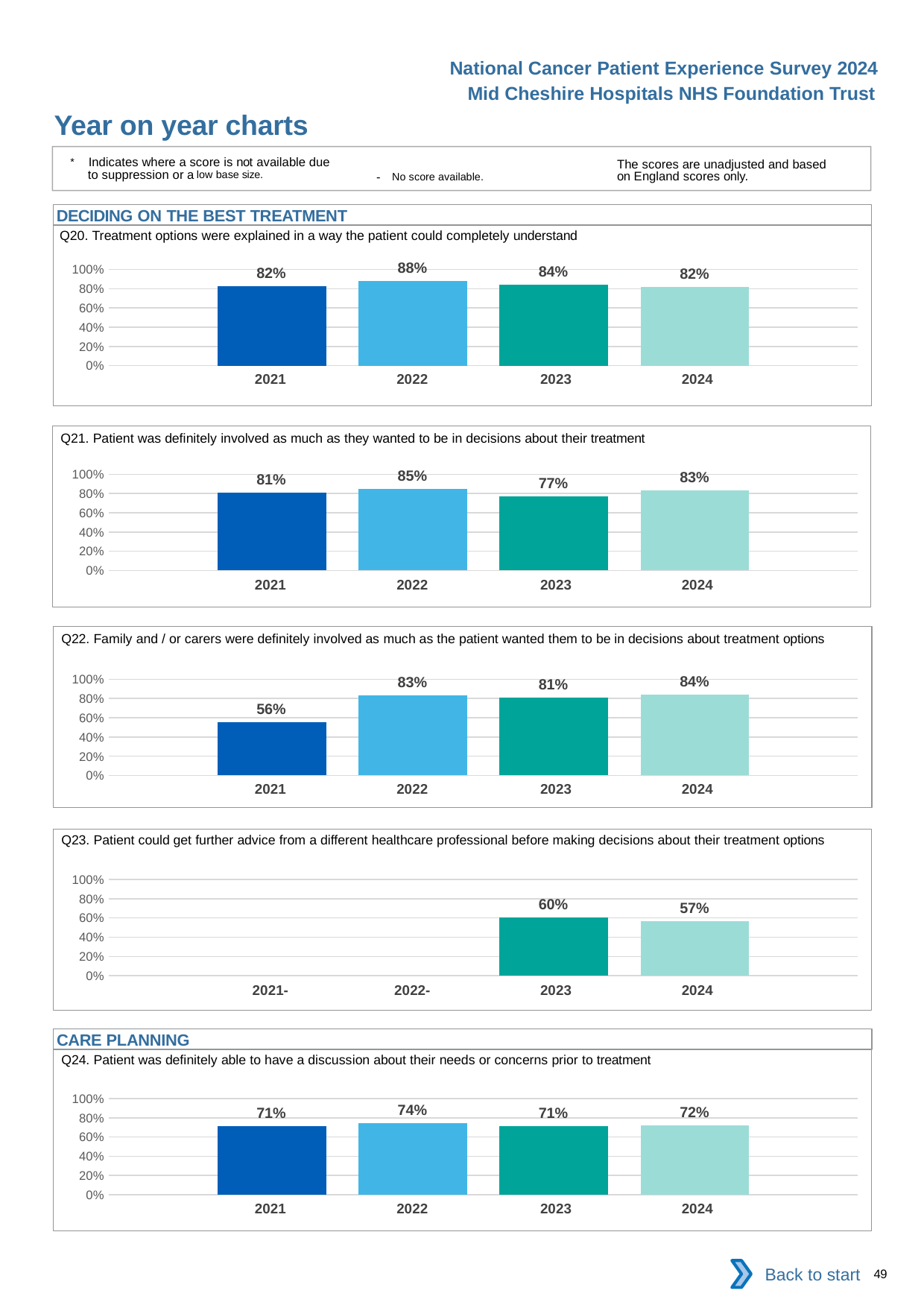
In the Q21 chart, what is the difference between the 2022 and 2023 values? 8% In the Q23 chart, how many years have a bar plotted? 2 What kind of chart is the Q24 chart? bar chart In the Q21 chart, which year has the lowest value? 2023 In the Q22 chart, what is the value for 2021? 56% In the Q24 chart, is the value for 2023 greater or less than 80%? less In the Q20 chart, what is the value for 2022? 88% In the Q20 chart, which year has the highest value? 2022 In the Q24 chart, which year has the highest value? 2022 In the Q22 chart, what is the difference between the 2024 and 2021 values? 28% In the Q23 chart, what is the value for 2024? 57% In the Q22 chart, which is larger, the value for 2021 or the value for 2024? 2024